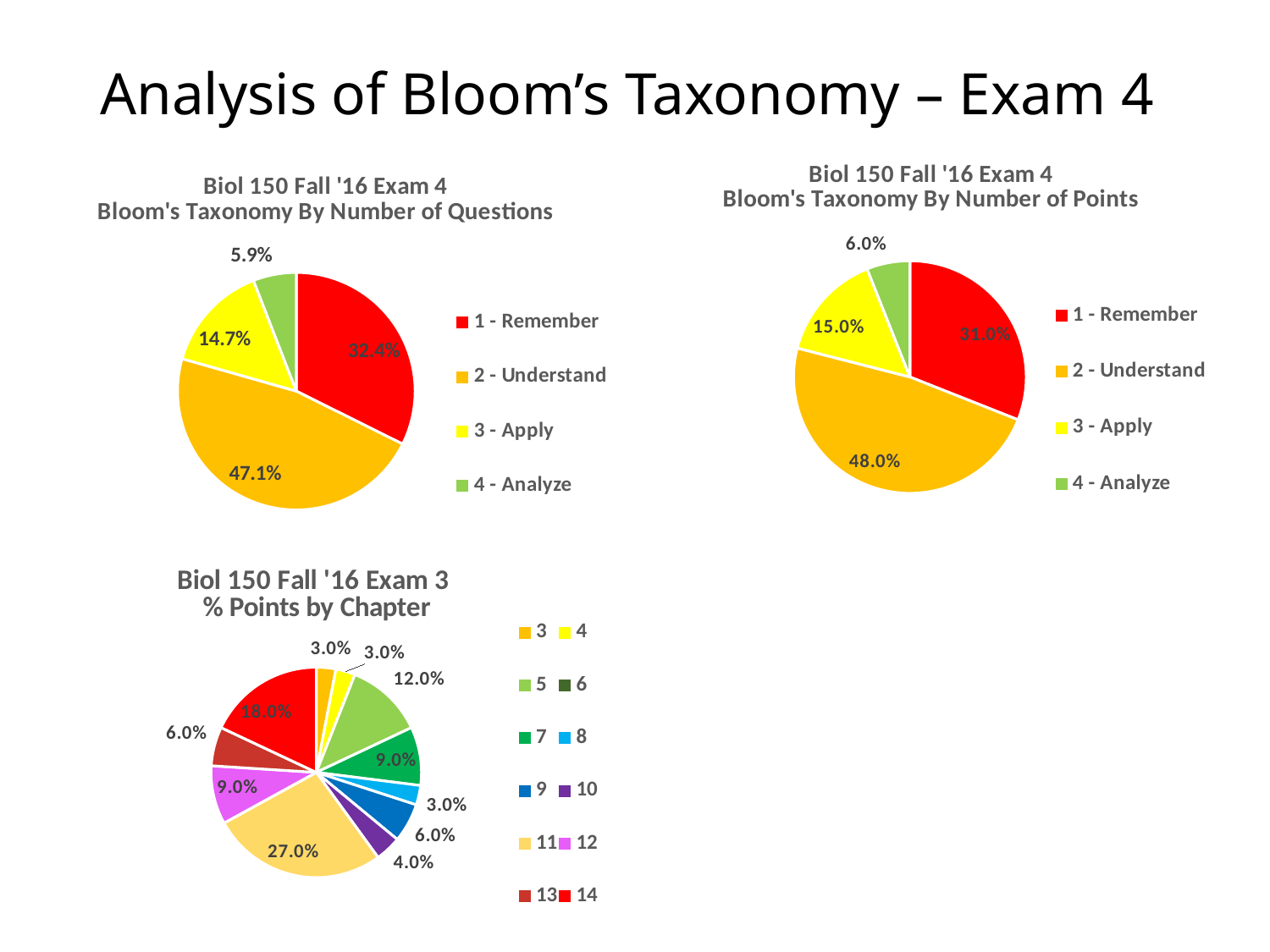
In the 'Bloom's Taxonomy By Number of Questions' chart, which category has the largest share? 2 - Understand In the 'Exam 3 % Points by Chapter' chart, what percentage is shown for chapter 11? 27.0% In the 'Bloom's Taxonomy By Number of Points' chart, what percentage is shown for 1 - Remember? 31.0% In the 'Bloom's Taxonomy By Number of Points' chart, which category has the smallest share? 4 - Analyze In the 'Bloom's Taxonomy By Number of Points' chart, how many categories does the legend list? 4 In the 'Bloom's Taxonomy By Number of Questions' chart, what percentage is shown for 2 - Understand? 47.1% What type of chart is the 'Exam 3 % Points by Chapter' chart? Pie chart In the 'Exam 3 % Points by Chapter' chart, what percentage is shown for chapter 14? 18.0% Which is larger: the share for 3 - Apply in the 'By Number of Questions' chart or in the 'By Number of Points' chart? By Number of Points In the 'Exam 3 % Points by Chapter' chart, how many chapters does the legend list? 12 In the 'Bloom's Taxonomy By Number of Questions' chart, what is the difference between the shares for 1 - Remember and 3 - Apply? 17.7% In the 'Bloom's Taxonomy By Number of Questions' chart, what percentage is shown for 4 - Analyze? 5.9%